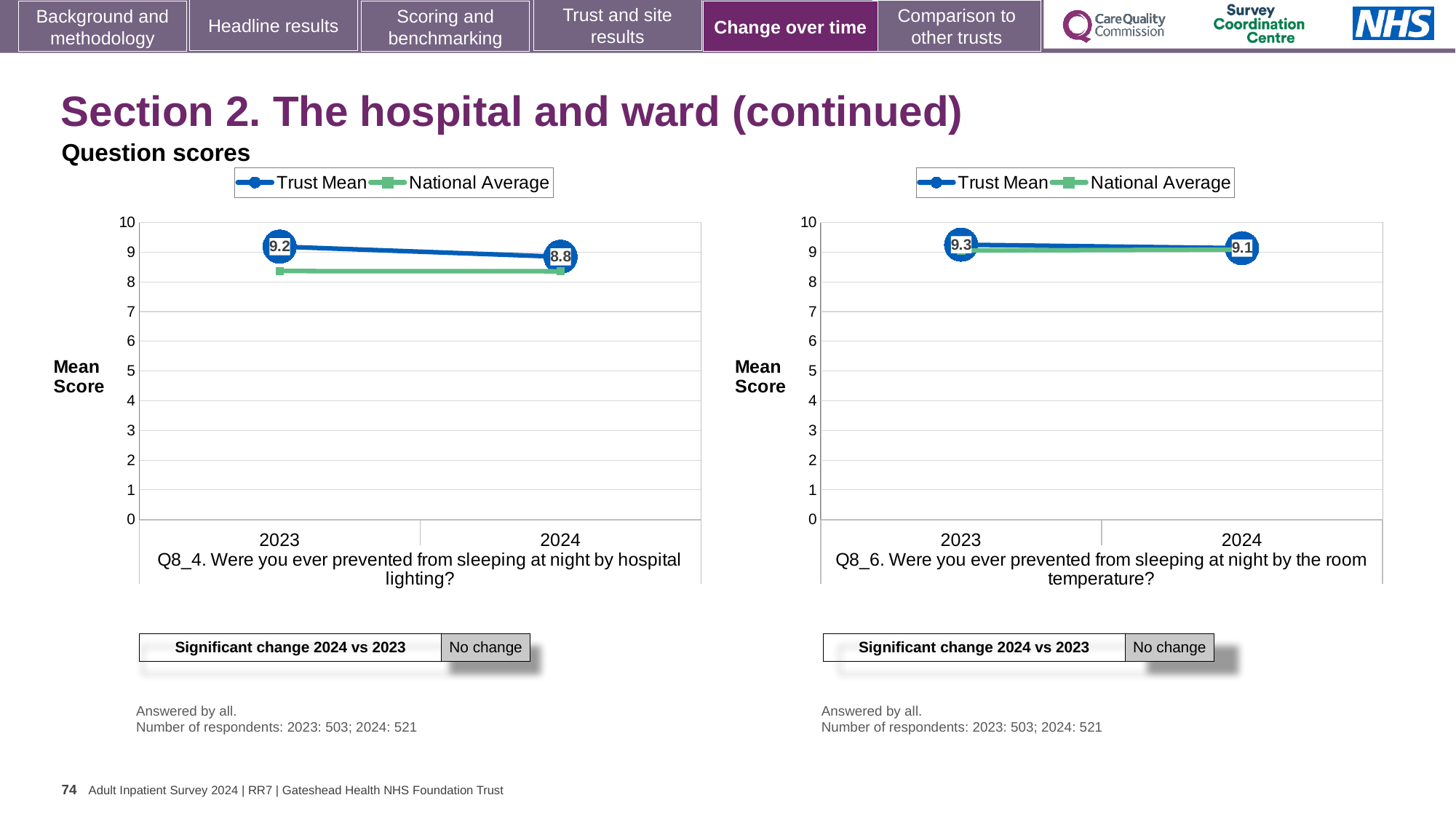
In the left chart (Q8_4, hospital lighting), what is the Trust Mean score for 2024? 8.8 In the right chart (Q8_6, room temperature), what is the Trust Mean score for 2023? 9.3 What kind of chart is used on this slide to show the question scores? line chart In the left chart (Q8_4, hospital lighting), which is higher in 2023: the Trust Mean or the National Average? Trust Mean In the right chart (Q8_6, room temperature), what is the Trust Mean score for 2024? 9.1 In the right chart (Q8_6, room temperature), what is the difference between the Trust Mean in 2023 and 2024? 0.2 In the left chart (Q8_4, hospital lighting), is the National Average for 2023 greater or less than 9? less In the left chart (Q8_4, hospital lighting), by how much did the Trust Mean fall from 2023 to 2024? 0.4 How many series does the legend of the left chart (Q8_4) list? 2 In the left chart (Q8_4, hospital lighting), what is the Trust Mean score for 2023? 9.2 In the left chart (Q8_4, hospital lighting), does the Trust Mean rise or fall from 2023 to 2024? fall How many years are plotted on the x axis of the right chart (Q8_6)? 2